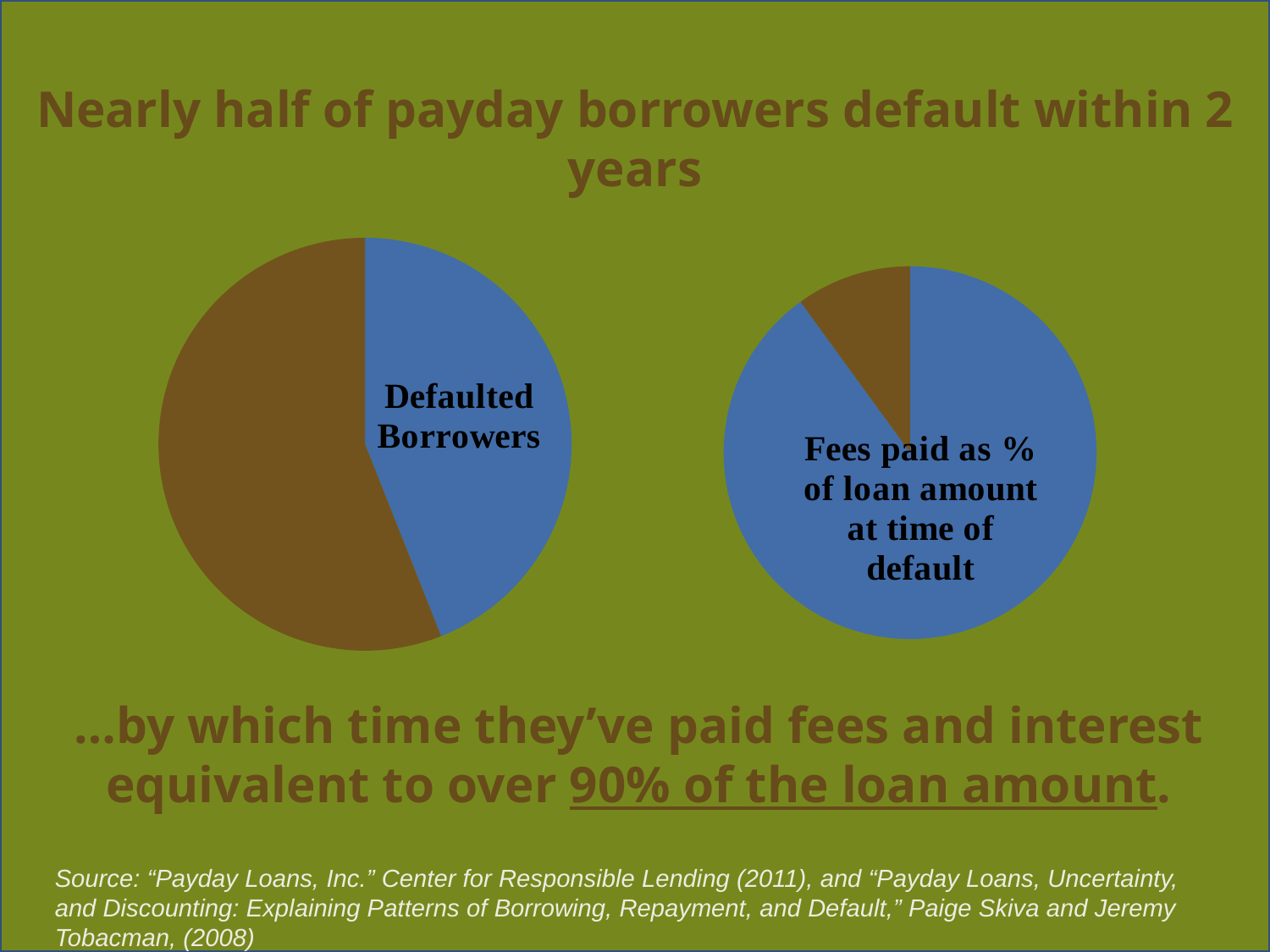
In the left pie chart ("Defaulted Borrowers"), which slice is larger, the blue one or the brown one? the brown one What label is printed on the right pie chart? Fees paid as % of loan amount at time of default How many slices does the left pie chart ("Defaulted Borrowers") have? 2 How many slices does the right pie chart ("Fees paid as % of loan amount at time of default") have? 2 How many pie charts are shown on the slide? 2 What kind of chart is the right chart labelled "Fees paid as % of loan amount at time of default"? pie chart In the right pie chart ("Fees paid as % of loan amount at time of default"), which slice is the smallest? the brown slice What label is printed on the left pie chart? Defaulted Borrowers What kind of chart is the left chart labelled "Defaulted Borrowers"? pie chart In the right pie chart ("Fees paid as % of loan amount at time of default"), which slice is larger, the blue one or the brown one? the blue one